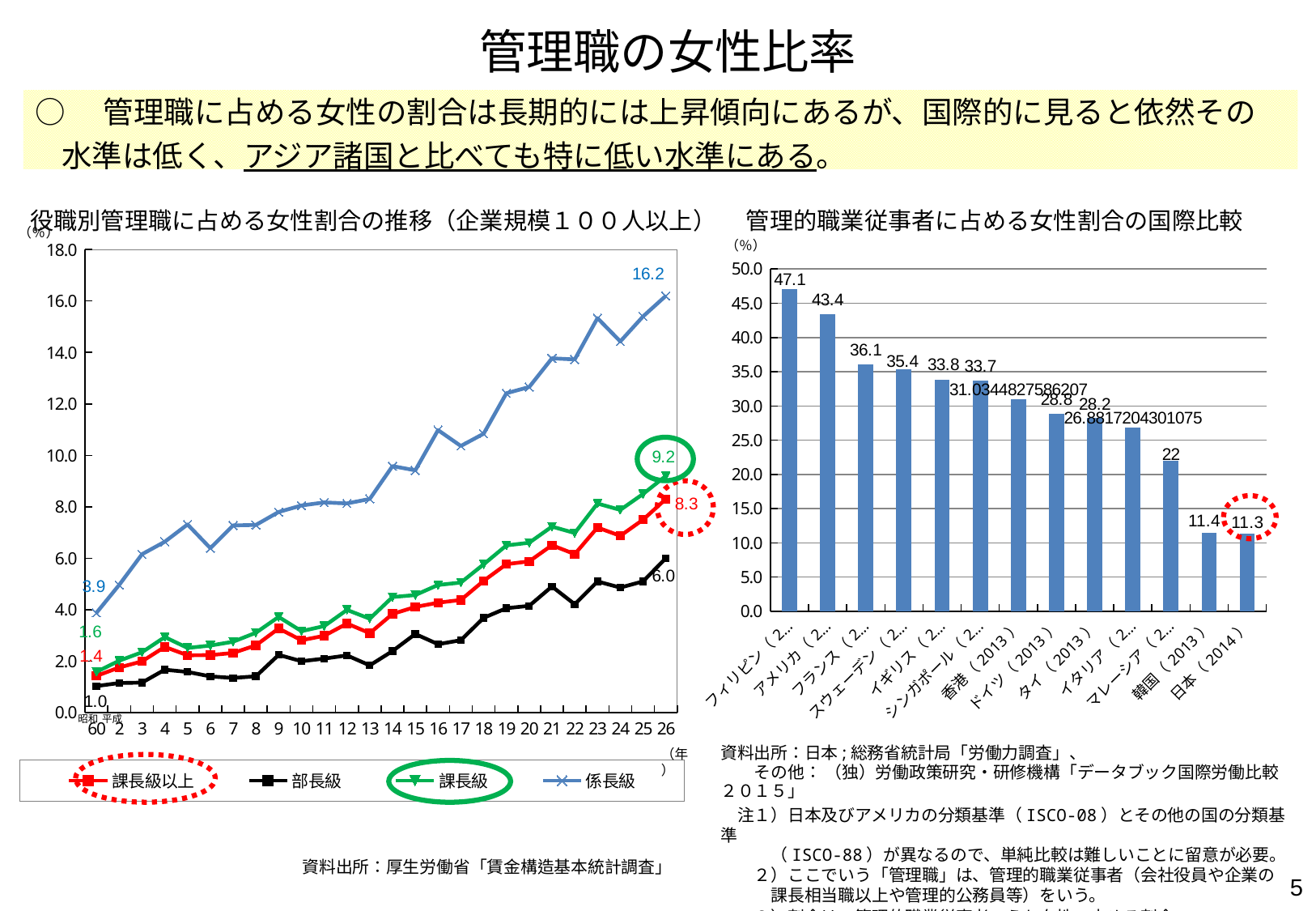
In the bar chart on the right, which country has the highest value? フィリピン In the bar chart on the right, what is the value for フィリピン? 47.1 In the line chart on the left (役職別管理職に占める女性割合の推移), what is the value for 係長級 in year 26? 16.2 In the bar chart on the right, is the value for マレーシア greater or less than 25.0? less In the bar chart on the right, how many countries/regions are shown? 13 In the bar chart on the right (管理的職業従事者に占める女性割合の国際比較), what is the value for 日本（2014）? 11.3 In the line chart on the left, what is the value for 課長級 in year 26? 9.2 What type of chart is the chart on the right of the slide? bar chart In the line chart on the left, how many series does the legend list? 4 In the line chart on the left, does the 係長級 series generally rise or fall over time? rise In the bar chart on the right, what is the difference between the values for アメリカ and 韓国（2013）? 32.0 In the bar chart on the right, which country has the lowest value? 日本